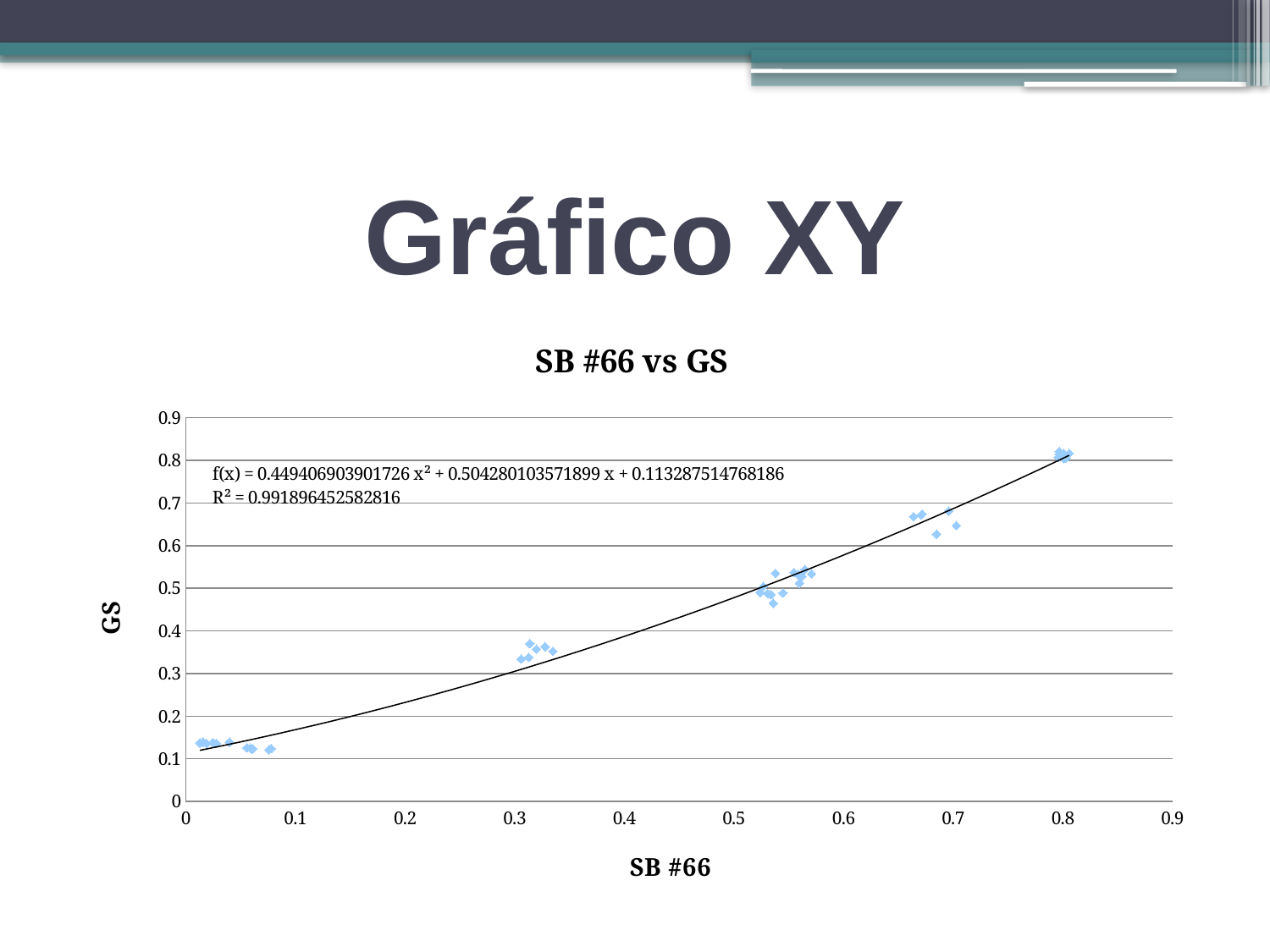
What R² value is printed on the chart for the fitted trendline? 0.991896452582816 What is the title of the chart? SB #66 vs GS What is the label of the horizontal axis? SB #66 What kind of chart is shown on the slide? scatter chart What is the coefficient of x² in the fitted equation shown on the chart? 0.449406903901726 Are the GS values for the points near SB #66 = 0.55 greater or less than 0.4? greater Are the GS values for the points near SB #66 = 0.3 greater or less than 0.4? less What is the constant term in the fitted equation shown on the chart? 0.113287514768186 Are the GS values for the points near SB #66 = 0.8 greater or less than 0.7? greater Do the GS values rise or fall as SB #66 increases? rise What is the highest value shown on the vertical axis? 0.9